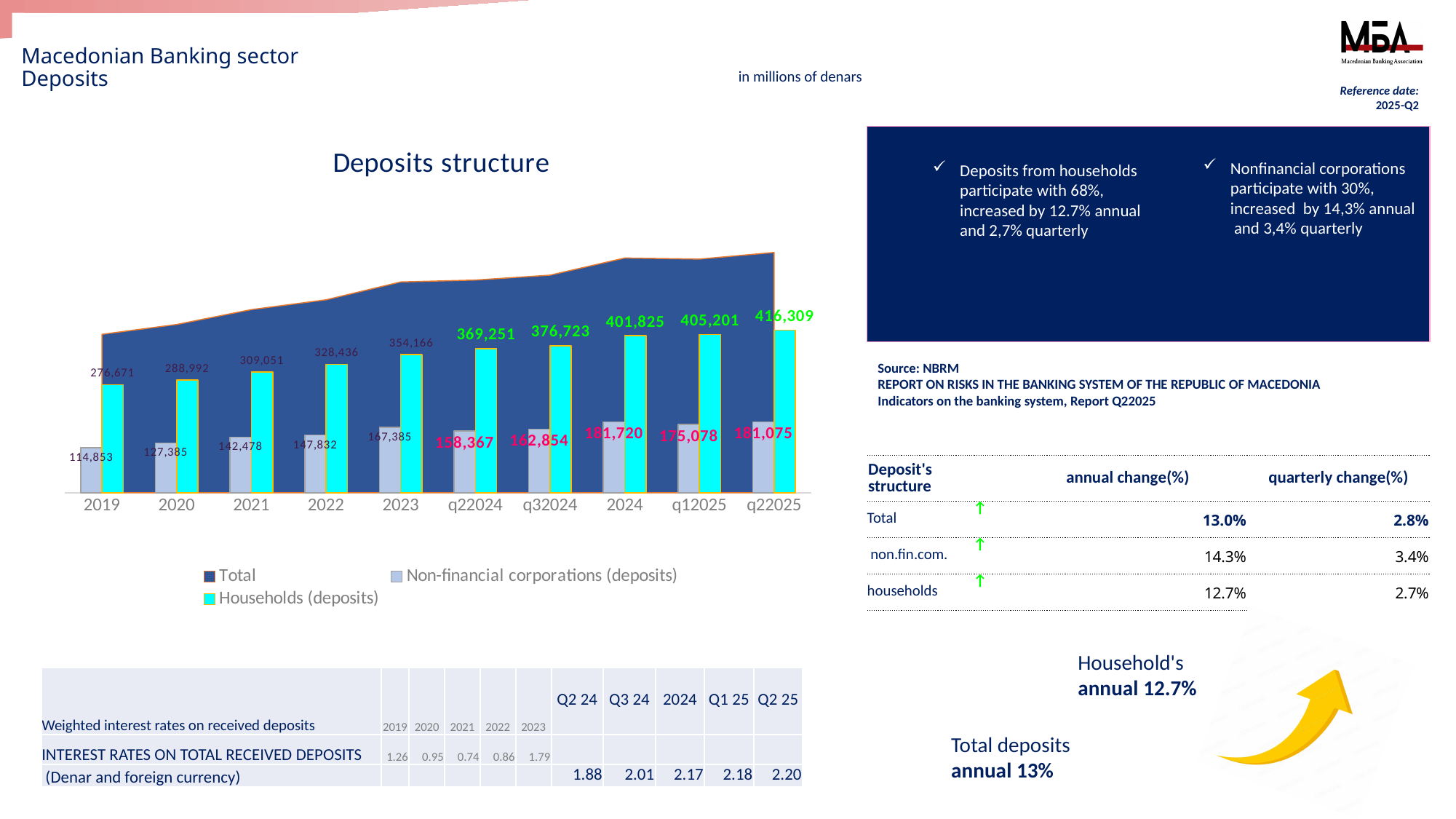
In the Deposits structure chart, what is the difference between the Non-financial corporations (deposits) values for 2024 and q12025? 6,642 In the Deposits structure chart, what is the difference between the Households (deposits) values for q22025 and q12025? 11,108 In the Deposits structure chart, which is larger for Non-financial corporations (deposits): 2023 or q22024? 2023 What is the title of the chart on the slide? Deposits structure How many series does the legend of the Deposits structure chart list? 3 In the Deposits structure chart, which period has the highest value for Households (deposits)? q22025 In the Deposits structure chart, what is the value for Households (deposits) in q22025? 416,309 In the Deposits structure chart, what is the value for Non-financial corporations (deposits) in 2019? 114,853 In the Deposits structure chart, which period has the lowest value for Non-financial corporations (deposits)? 2019 In the Deposits structure chart, what is the value for Non-financial corporations (deposits) in 2024? 181,720 How many periods are shown on the x axis of the Deposits structure chart? 10 In the Deposits structure chart, do the Households (deposits) values rise or fall from 2019 to q22025? rise